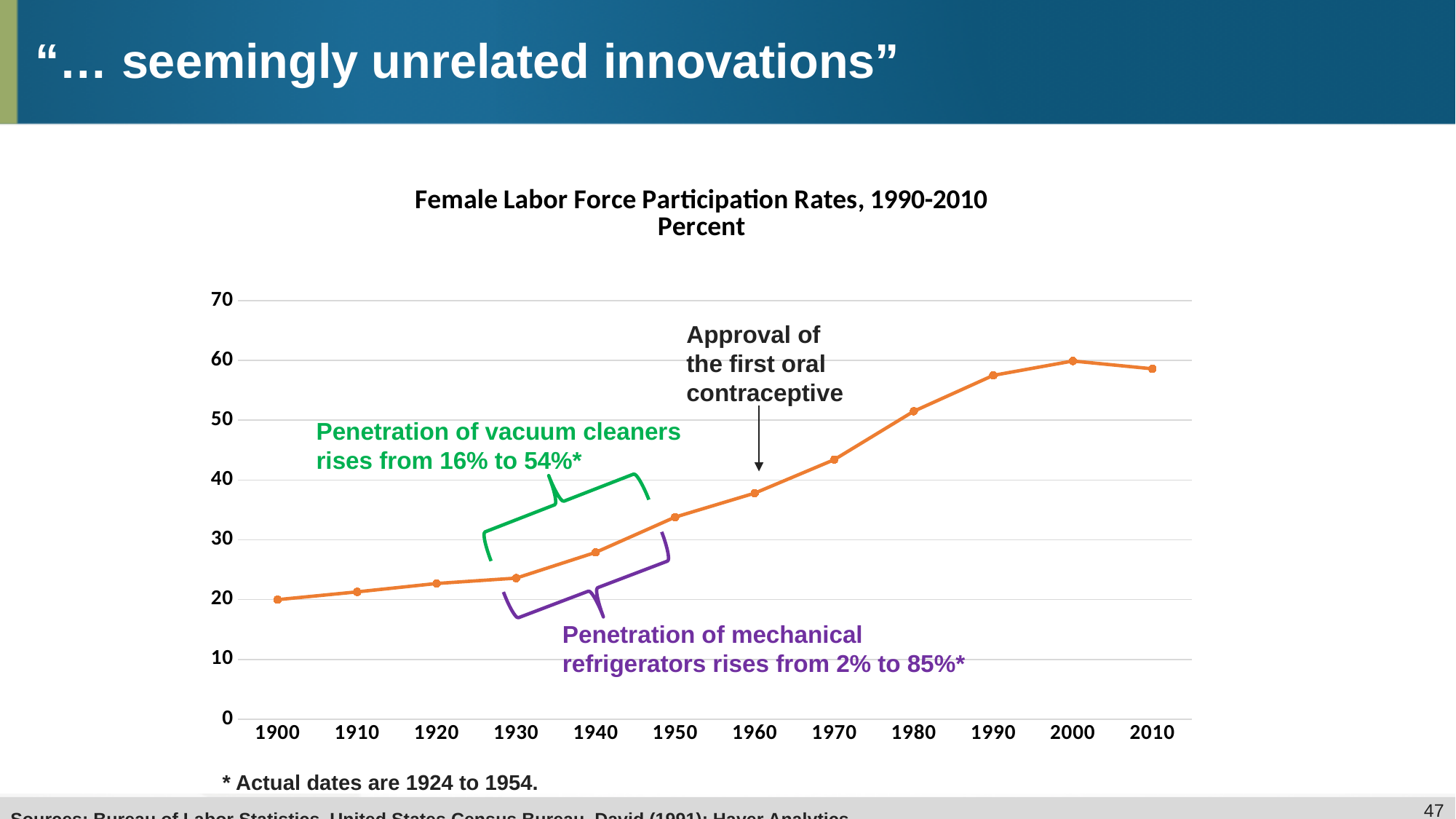
Is the value for 1950 greater or less than 30? greater How many data points are plotted on the line? 12 What is the title of the chart? Female Labor Force Participation Rates, 1990-2010 Which year has the highest female labor force participation rate? 2000 What kind of chart is shown on the slide? line chart According to the annotation, what event is marked with an arrow at 1960? Approval of the first oral contraceptive Is the value for 1970 greater or less than 40? greater Does the female labor force participation rate generally rise or fall from 1900 to 2000? rise Which year has the lowest female labor force participation rate? 1900 Is the value for 1960 greater or less than 40? less Which year has a higher participation rate, 1950 or 1970? 1970